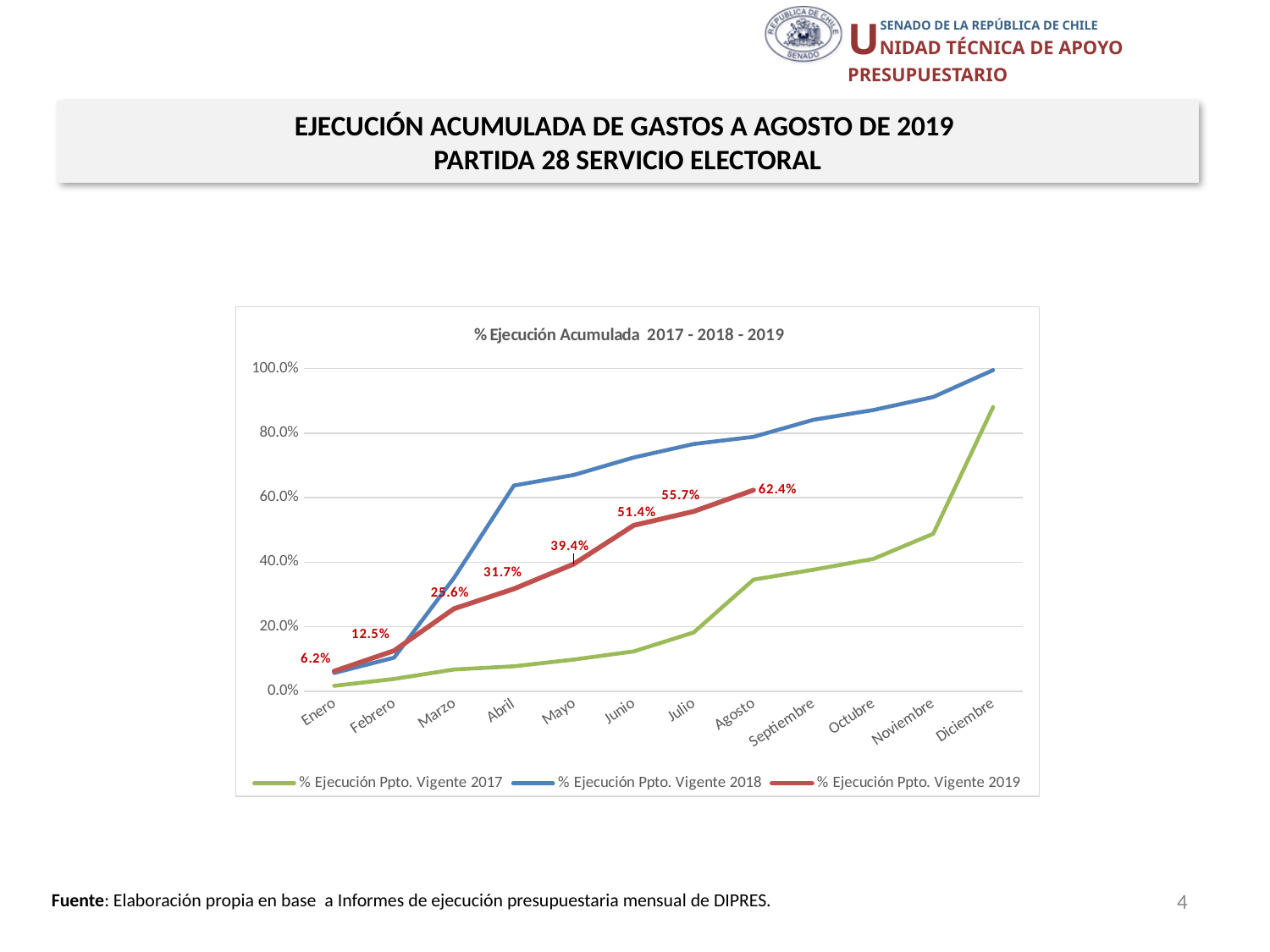
How many series does the legend list? 3 What is the difference between the 2019 values for Junio and Mayo? 12.0% What is the value of % Ejecución Ppto. Vigente 2019 for Enero? 6.2% How many months are shown on the x axis of the chart? 12 Is the value of % Ejecución Ppto. Vigente 2018 for Diciembre greater or less than 80.0%? greater What is the value of % Ejecución Ppto. Vigente 2019 for Marzo? 25.6% Does the % Ejecución Ppto. Vigente 2019 line rise or fall from Enero to Agosto? Rise What is the value of % Ejecución Ppto. Vigente 2019 for Agosto? 62.4% By how many percentage points did % Ejecución Ppto. Vigente 2019 increase from Julio to Agosto? 6.7% In Abril, which series has the larger value: % Ejecución Ppto. Vigente 2018 or % Ejecución Ppto. Vigente 2019? % Ejecución Ppto. Vigente 2018 What kind of chart is shown on the slide? Line chart What is the value of % Ejecución Ppto. Vigente 2019 for Mayo? 39.4%